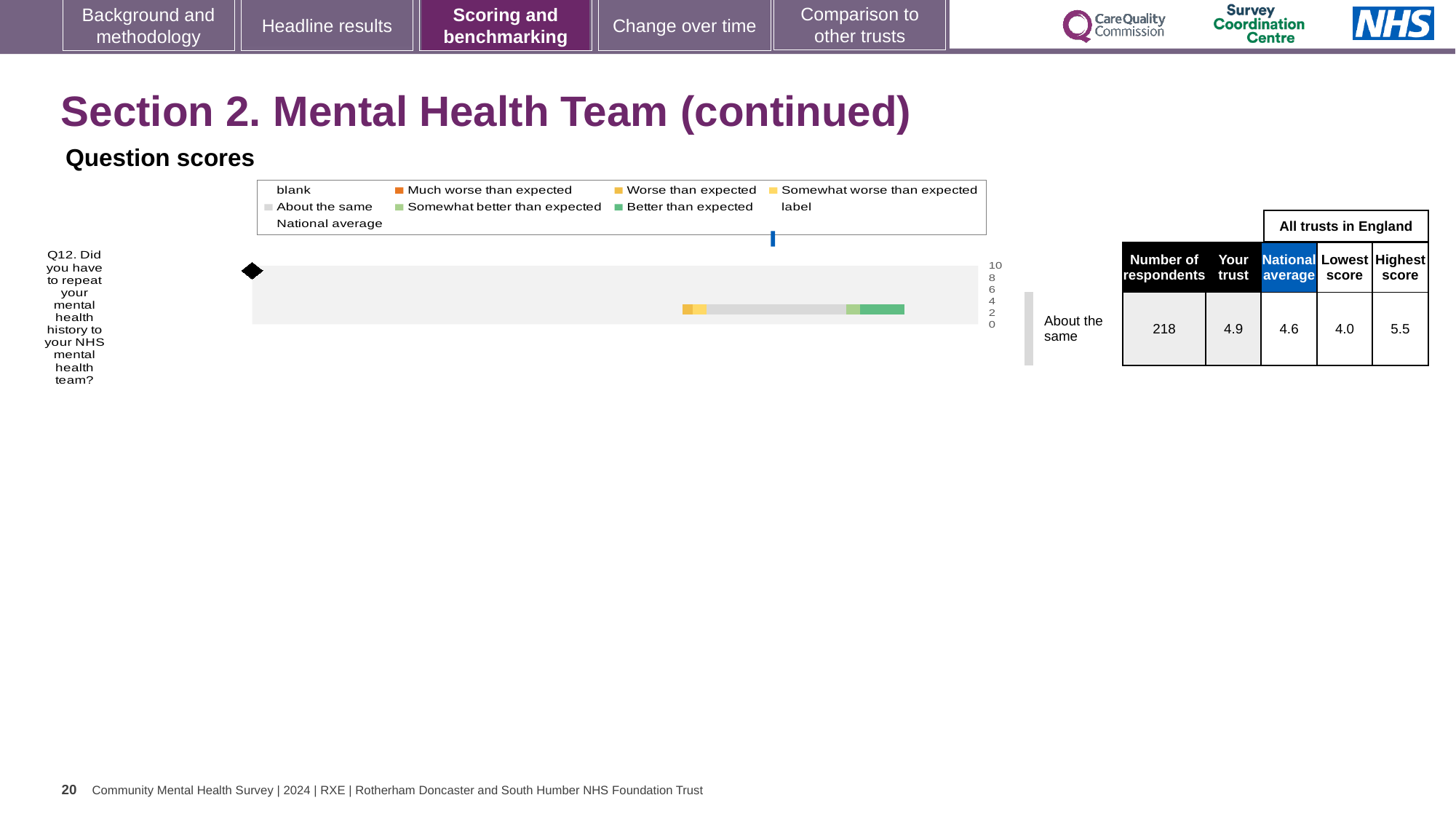
Which is larger for Q12, the 'Your trust' score or the national average? Your trust What is the lowest score among all trusts in England for Q12? 4.0 What is the difference between the highest and lowest scores for Q12 among all trusts in England? 1.5 What is the national average score for Q12? 4.6 What is the 'Your trust' score for Q12? 4.9 Which question is plotted in the chart? Q12. Did you have to repeat your mental health history to your NHS mental health team? What kind of chart is used to show the Q12 question score? bar chart What is the highest score among all trusts in England for Q12? 5.5 What benchmark category is shown next to the chart for Q12? About the same How many survey questions are plotted in the chart? 1 What colour represents 'Better than expected' in the chart legend? green How many respondents answered Q12? 218